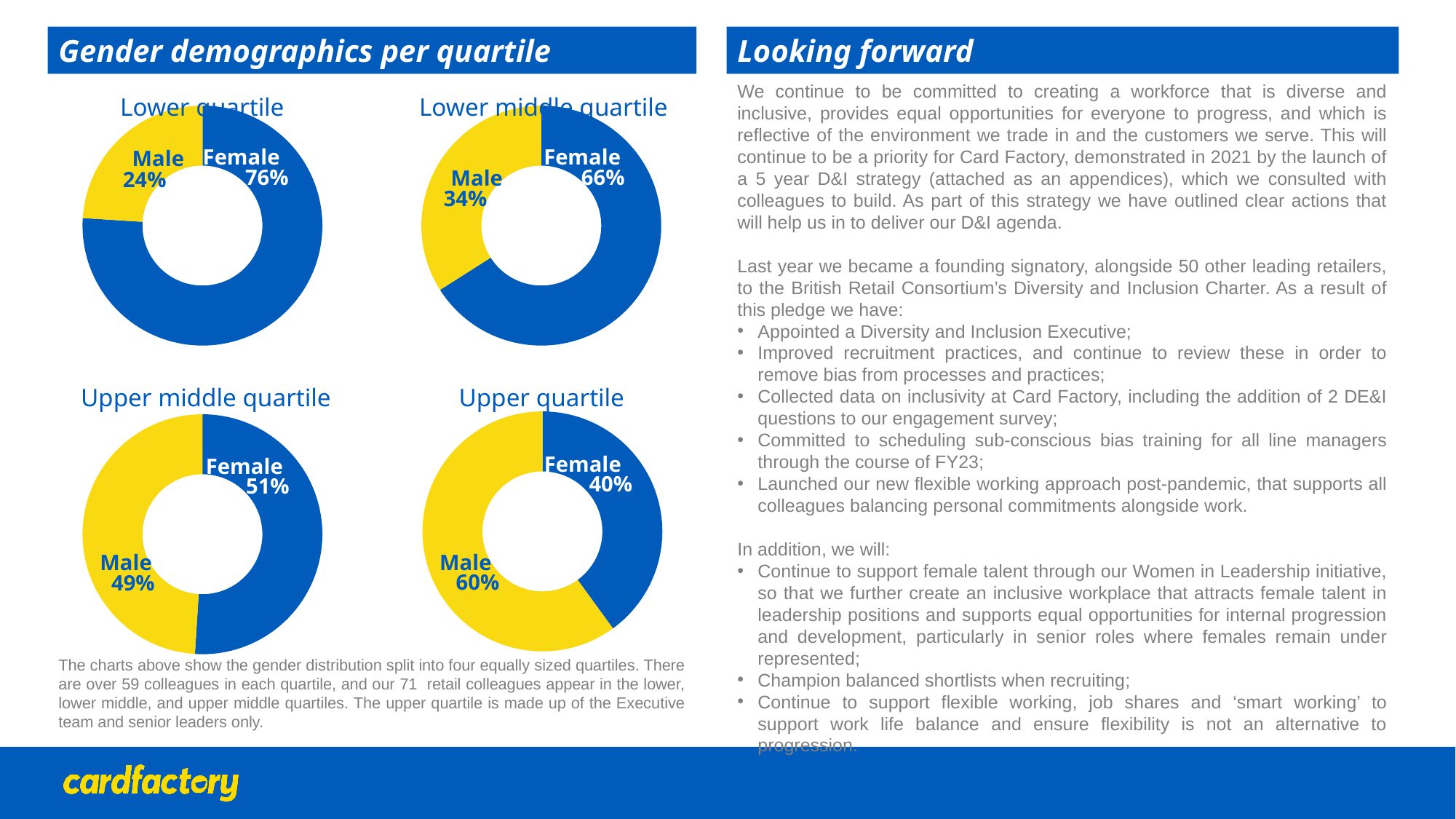
In the Lower middle quartile chart, what percentage is Male? 34% In the Lower quartile chart, what percentage is Female? 76% How many slices does the Upper middle quartile chart have? 2 In the Upper quartile chart, which slice is the smallest? Female In the Lower middle quartile chart, what colour is the Male slice? Yellow In the Upper middle quartile chart, what percentage is Female? 51% In the Lower middle quartile chart, what is the difference between the Female and Male percentages? 32% In the Lower quartile chart, which slice is the largest? Female In the Upper quartile chart, what percentage is Male? 60% In the Lower quartile chart, what percentage is Male? 24% What kind of chart is used for the Lower quartile? Doughnut chart In the Upper quartile chart, which is larger, Male or Female? Male